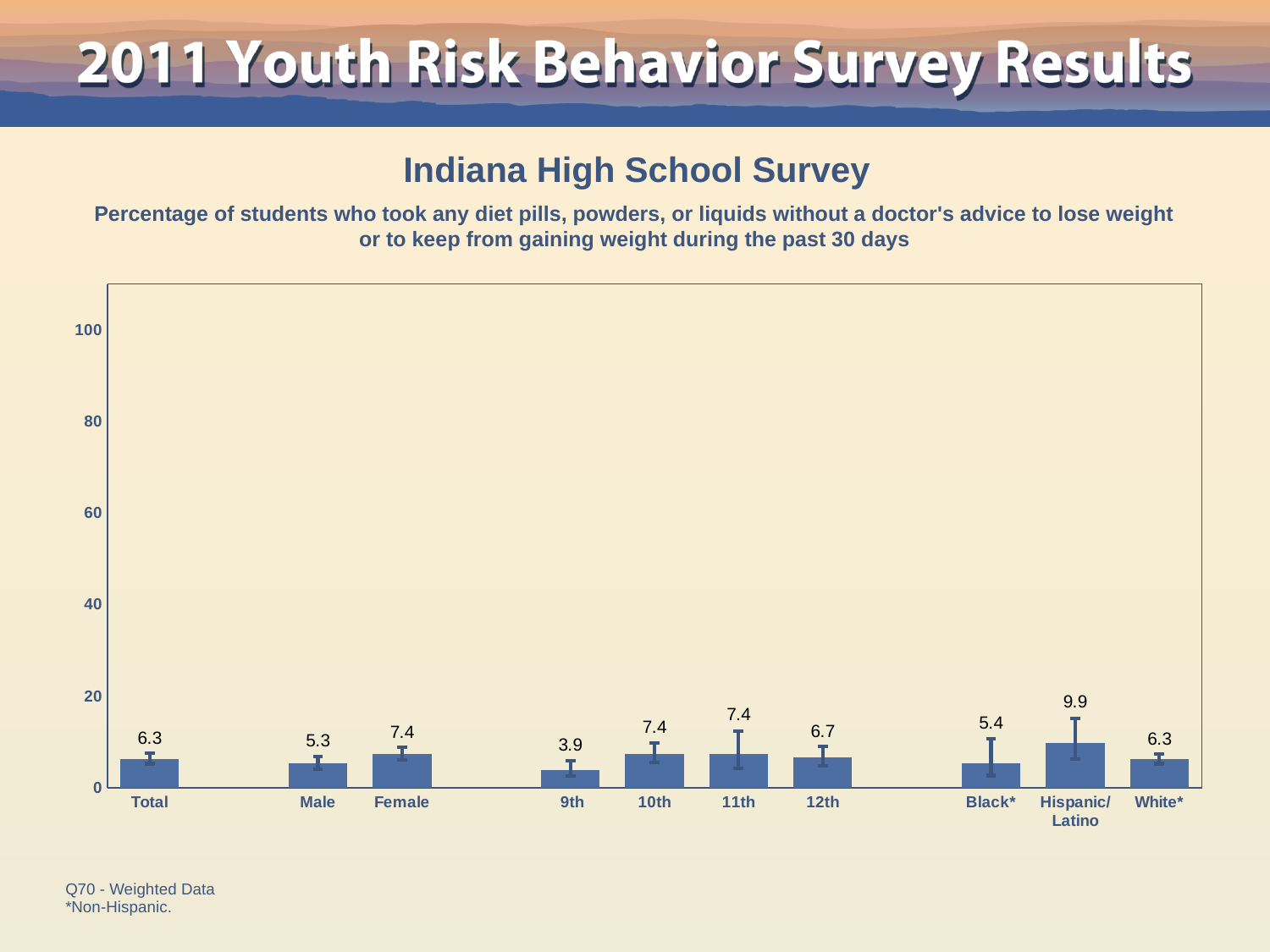
How many categories are shown on the x axis? 10 What is the difference between the Female and Male values? 2.1 Which is larger, the value for Black* or the value for White*? White* What is the value for Hispanic/Latino? 9.9 What kind of chart is shown? bar chart Which category has the highest value? Hispanic/Latino What is the highest value shown on the y axis? 100 What is the value for Total? 6.3 What is the value for 9th grade? 3.9 What is the value for Female? 7.4 Is the value for 12th grade greater or less than 20? less Which category has the lowest value? 9th